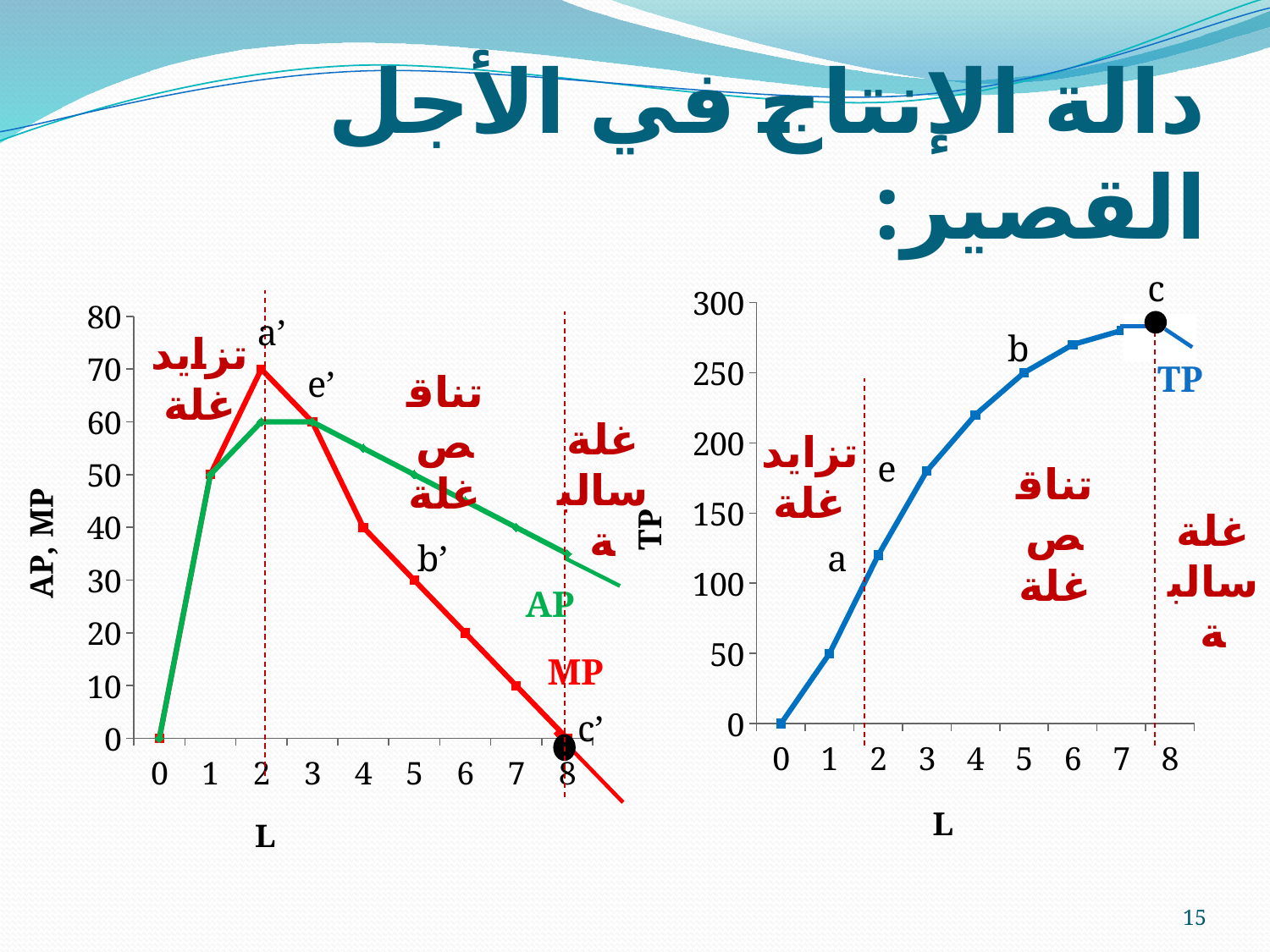
In the left chart (AP, MP), which is larger at L = 5, AP or MP? AP In the right chart (TP), what is the value of TP at L = 1? 50 In the right chart (TP), what is the label on the x axis? L In the right chart (TP), is the value of TP at L = 3 greater or less than 150? greater In the left chart (AP, MP), does the MP curve rise or fall as L increases from 2 to 8? fall In the left chart (AP, MP), what is the value of MP at L = 2? 70 In the left chart (AP, MP), what is the value of MP at L = 8? 0 In the left chart (AP, MP), at which value of L does the MP curve reach its highest point? 2 What kind of chart is the right chart (TP)? line chart In the left chart (AP, MP), is the value of AP at L = 8 greater or less than 30? greater What kind of chart is the left chart (AP, MP)? line chart In the right chart (TP), what is the value of TP at L = 5? 250